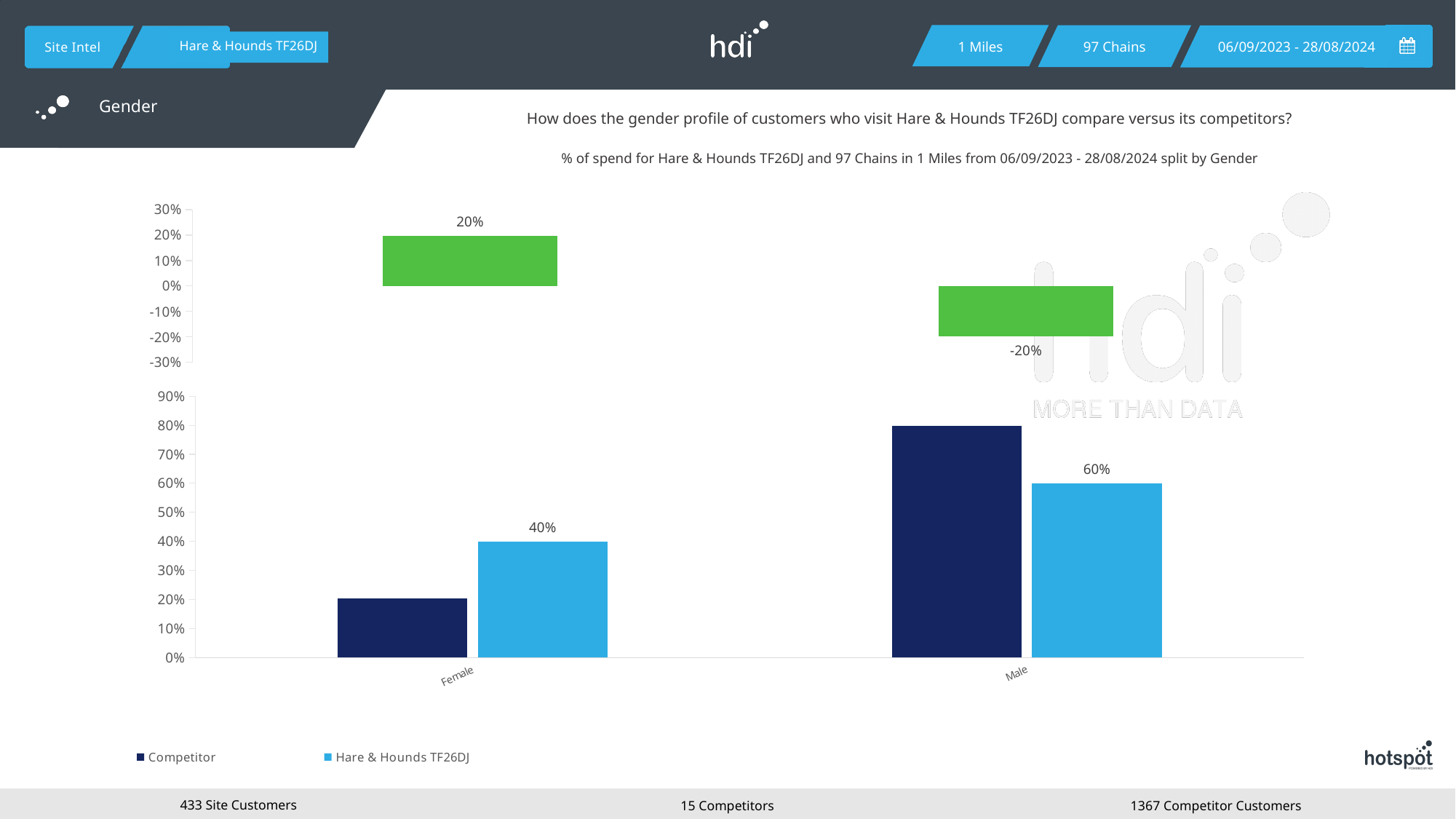
In the top chart, what is the value shown for the Female category? 20% In the bottom chart, is the Competitor value for Female greater or less than 30%? less What type of chart is the bottom chart? Bar chart In the bottom chart, what is the difference between the Hare & Hounds TF26DJ values for Male and Female? 20% In the bottom chart, what is the value for Hare & Hounds TF26DJ in the Female category? 40% In the bottom chart, is the Competitor value for Male greater or less than 70%? greater In the bottom chart, what is the value for Hare & Hounds TF26DJ in the Male category? 60% In the bottom chart, for the Female category, which series has the larger bar, Competitor or Hare & Hounds TF26DJ? Hare & Hounds TF26DJ How many categories are shown on the x axis of the bottom chart? 2 How many series does the legend of the bottom chart list? 2 In the bottom chart, which category has the higher Hare & Hounds TF26DJ value, Female or Male? Male In the top chart, what is the value shown for the Male category? -20%